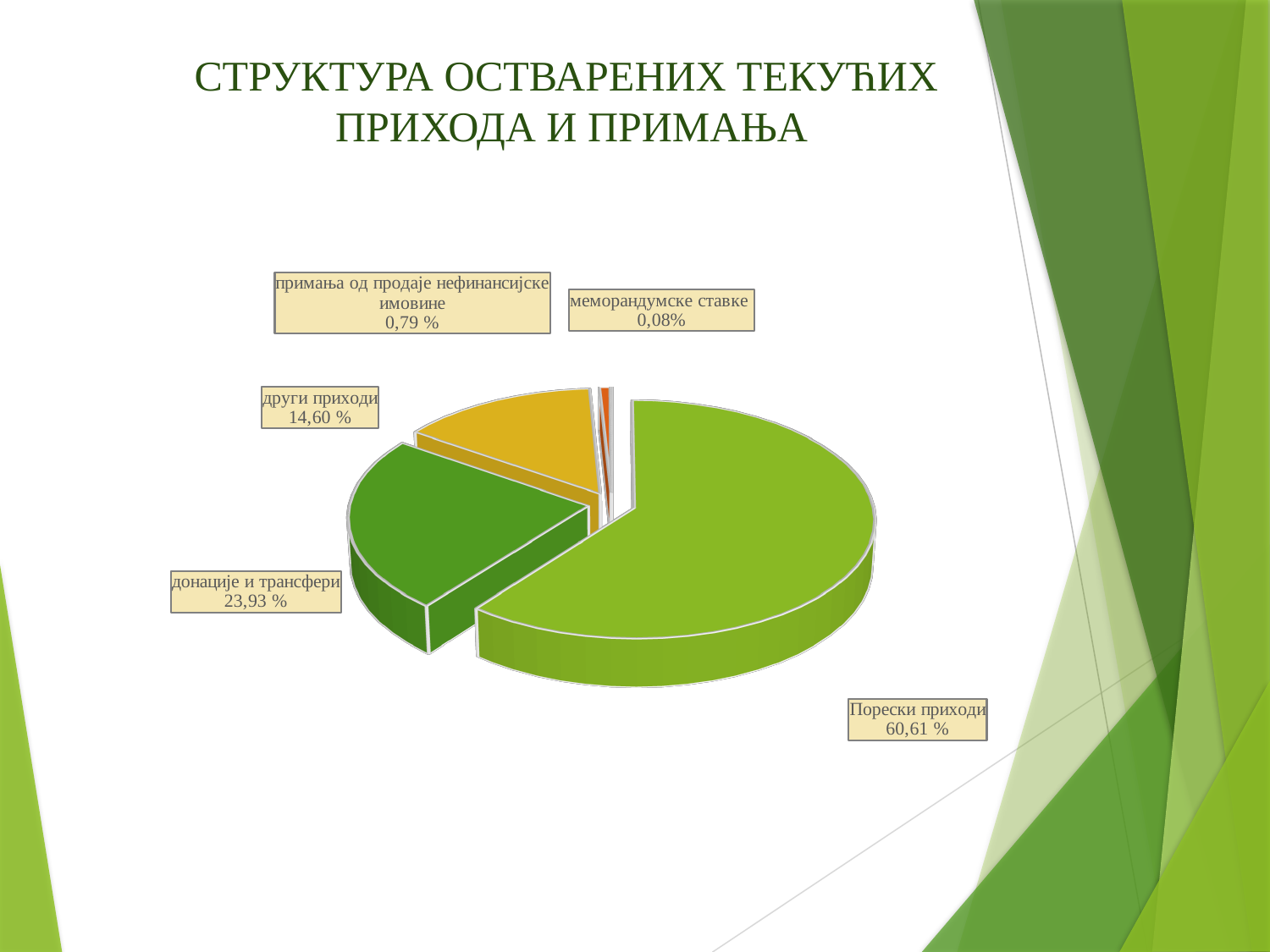
What is the share for други приходи? 14,60 % What type of chart is shown on the slide? pie chart What is the difference in percentage points between Порески приходи and донације и трансфери? 36,68 What is the share for меморандумске ставке? 0,08% How many slices does the pie chart have? 5 Which is larger, the share for донације и трансфери or the share for други приходи? донације и трансфери What is the share for донације и трансфери? 23,93 % Which category has the largest share of the pie? Порески приходи What is the share for Порески приходи? 60,61 % Which category has the smallest share of the pie? меморандумске ставке What is the share for примања од продаје нефинансијске имовине? 0,79 % What is the title of the slide containing the chart? СТРУКТУРА ОСТВАРЕНИХ ТЕКУЋИХ ПРИХОДА И ПРИМАЊА